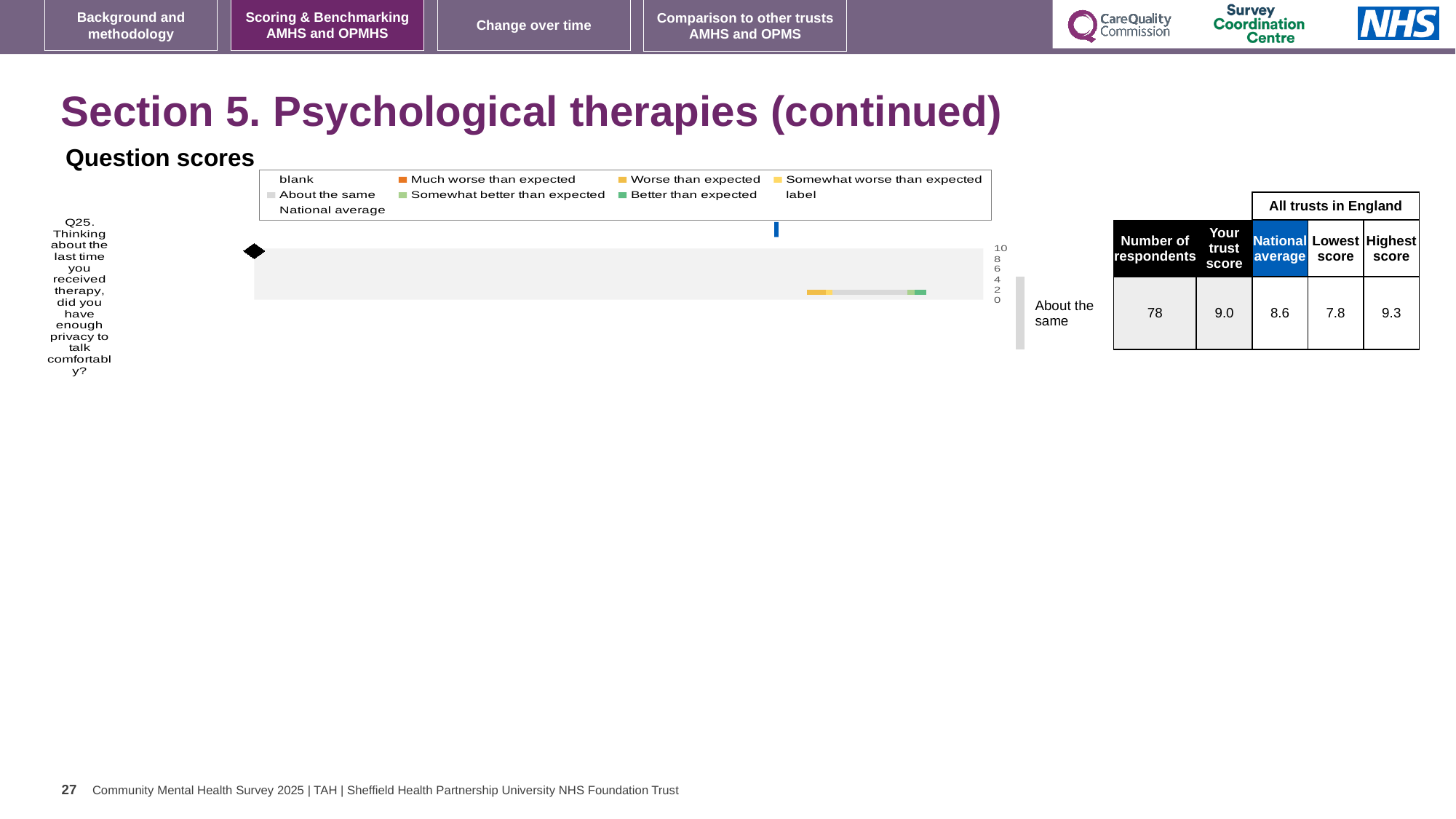
What is the highest tick value shown on the score axis of the Question scores chart? 10 How many questions (categories) are plotted in the Question scores chart? 1 Which question is plotted in the Question scores chart? Q25. Thinking about the last time you received therapy, did you have enough privacy to talk comfortably? In the table beside the chart, what is the trust's score for Q25? 9.0 In the table beside the chart, which is larger for Q25: the trust's score or the national average? the trust's score In the table beside the chart, how many respondents answered Q25? 78 What kind of chart is shown under the 'Question scores' heading? bar chart According to the label beside the chart, how does the trust's score for Q25 compare with expectation? About the same In the table beside the chart, what is the national average for Q25? 8.6 In the table beside the chart, what is the difference between the highest score and the lowest score for Q25? 1.5